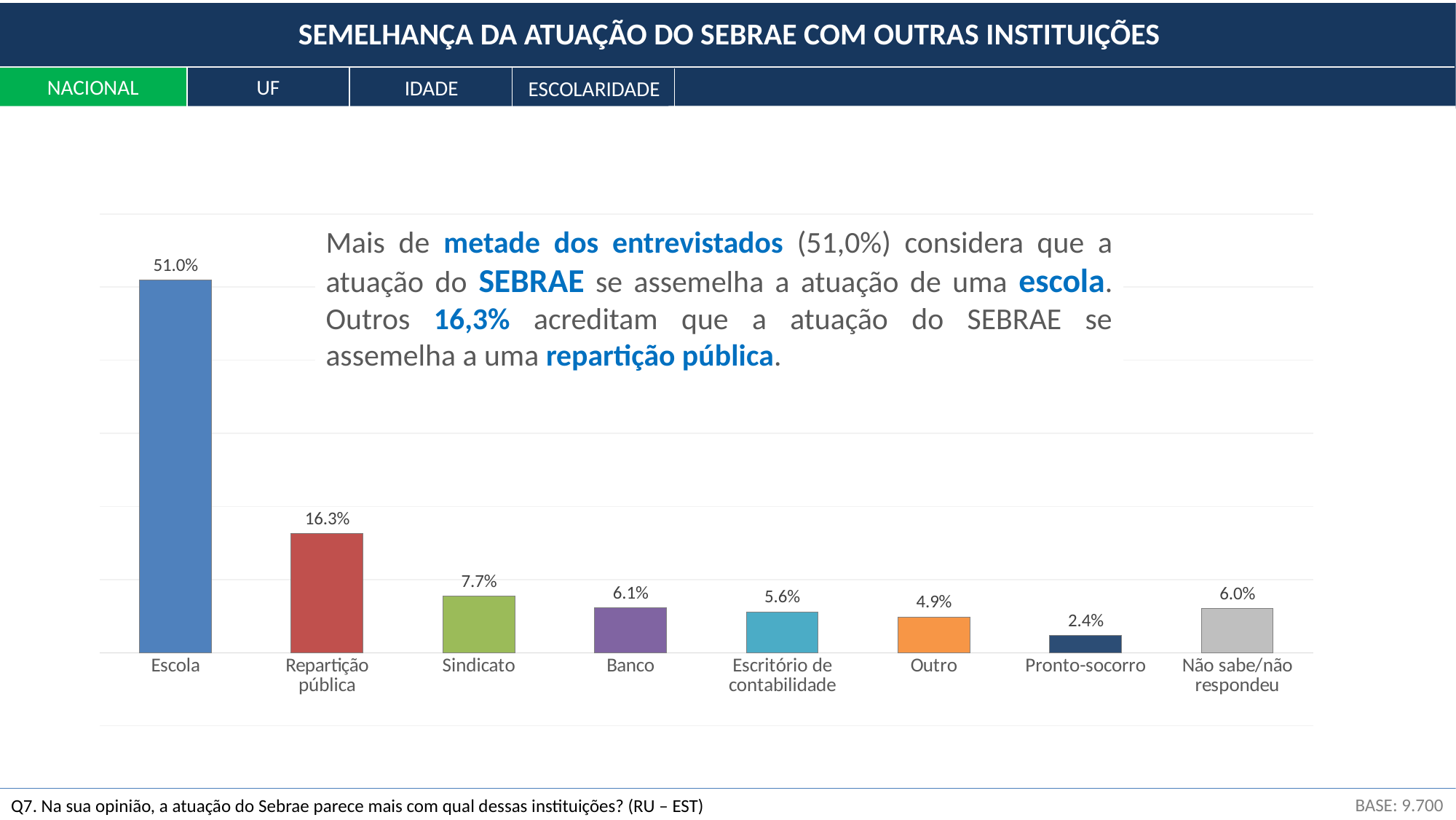
What is the difference between the values for Escola and Repartição pública? 34.7% Which category has the highest value? Escola What is the value for Escola? 51.0% What kind of chart is shown on the slide? Bar chart What is the value for Repartição pública? 16.3% What is the difference between the values for Sindicato and Banco? 1.6% Which category has the lowest value? Pronto-socorro What is the value for Não sabe/não respondeu? 6.0% What colour is the bar for Sindicato? Green What is the value for Escritório de contabilidade? 5.6% Which is larger, the value for Banco or the value for Outro? Banco How many categories are shown on the x axis? 8